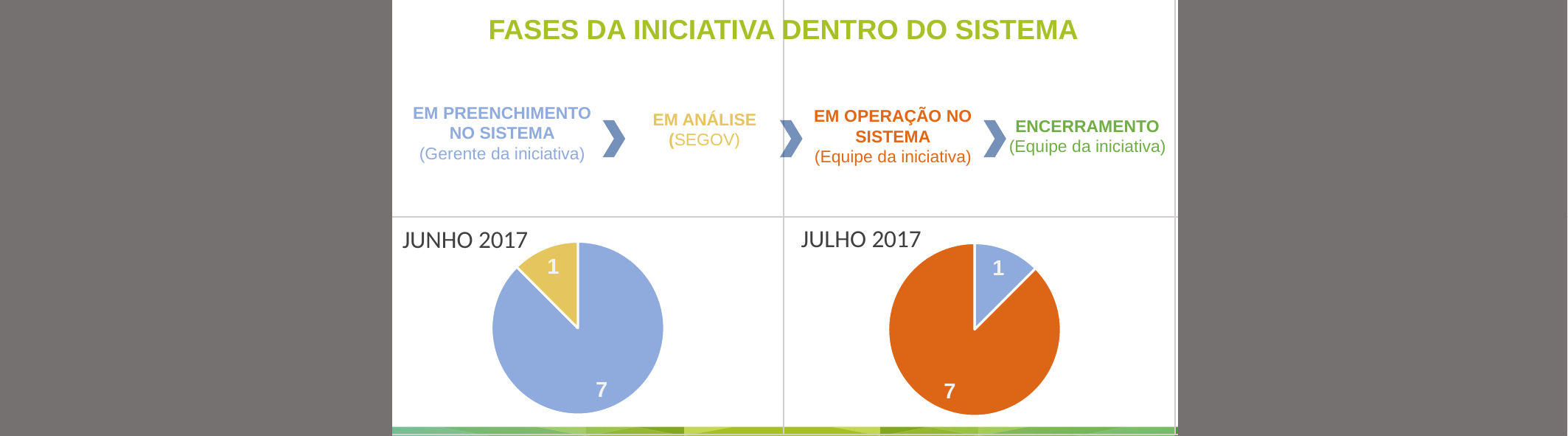
In the JUNHO 2017 pie chart, what is the value of the blue slice? 7 How many slices does the JUNHO 2017 pie chart have? 2 What kind of chart is shown under JULHO 2017? pie chart In the JULHO 2017 pie chart, what is the difference between the orange slice and the blue slice? 6 In the JULHO 2017 pie chart, what is the value of the blue slice? 1 What is the title at the top of the slide above the two pie charts? FASES DA INICIATIVA DENTRO DO SISTEMA How many slices does the JULHO 2017 pie chart have? 2 In the JUNHO 2017 pie chart, what is the total of all slices? 8 What kind of chart is shown under JUNHO 2017? pie chart In the JUNHO 2017 pie chart, which slice is larger, the blue one or the yellow one? the blue one In the JUNHO 2017 pie chart, what is the value of the yellow slice? 1 In the JULHO 2017 pie chart, what is the value of the orange slice? 7